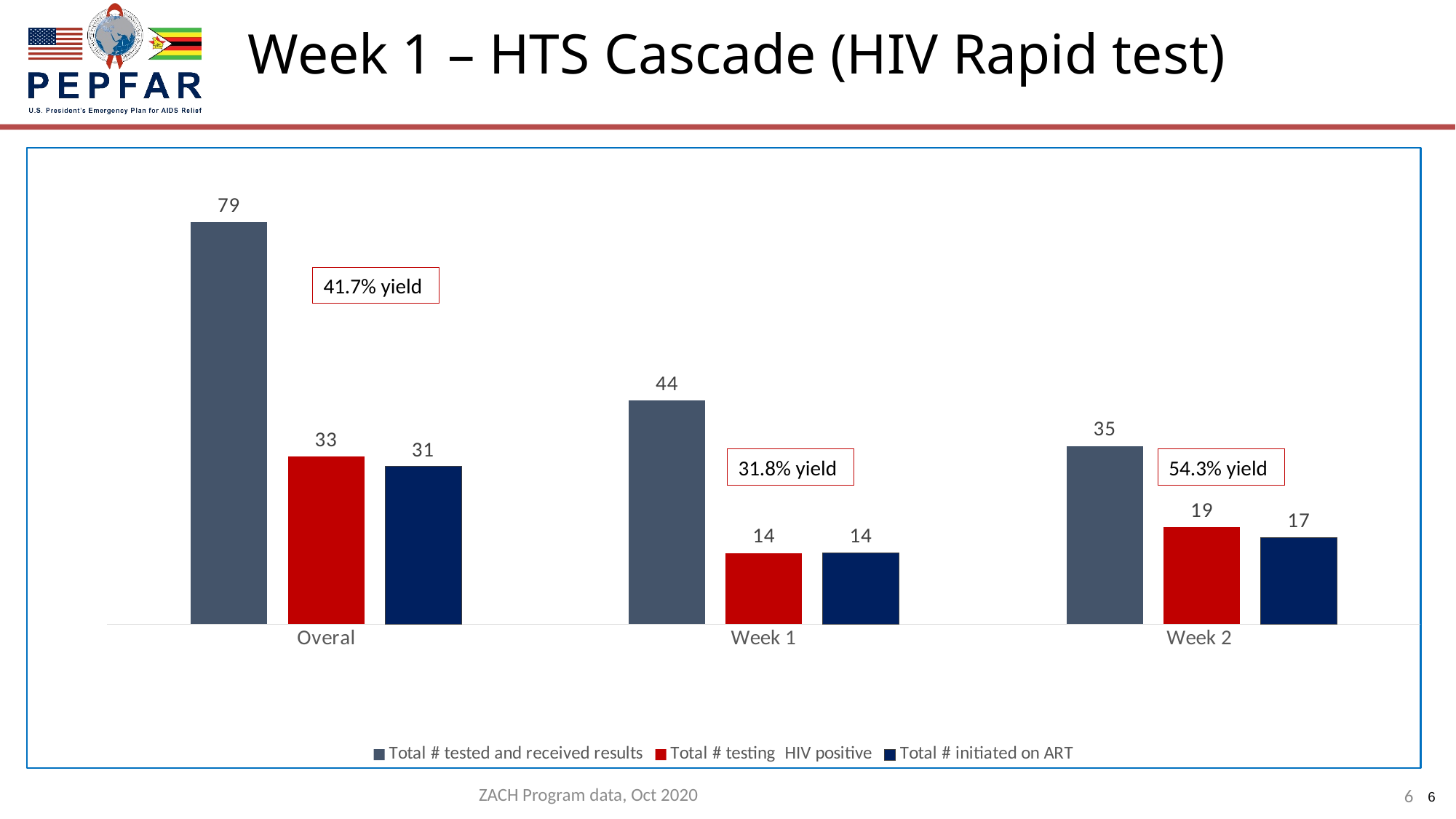
Which category has the lowest value for 'Total # testing HIV positive'? Week 1 What is the value of 'Total # testing HIV positive' for Week 2? 19 What is the value of 'Total # initiated on ART' for Week 1? 14 What yield percentage is shown in the text box for Week 2? 54.3% yield What is the difference between 'Total # tested and received results' for Week 1 and Week 2? 9 Which is larger: 'Total # initiated on ART' for Week 2 or for Week 1? Week 2 Which category has the highest value for 'Total # tested and received results'? Overal How many series does the legend list? 3 What is the value of 'Total # tested and received results' for Overal? 79 What is the difference between 'Total # testing HIV positive' and 'Total # initiated on ART' for Overal? 2 What kind of chart is shown on the slide? Bar chart How many categories are shown on the x axis? 3